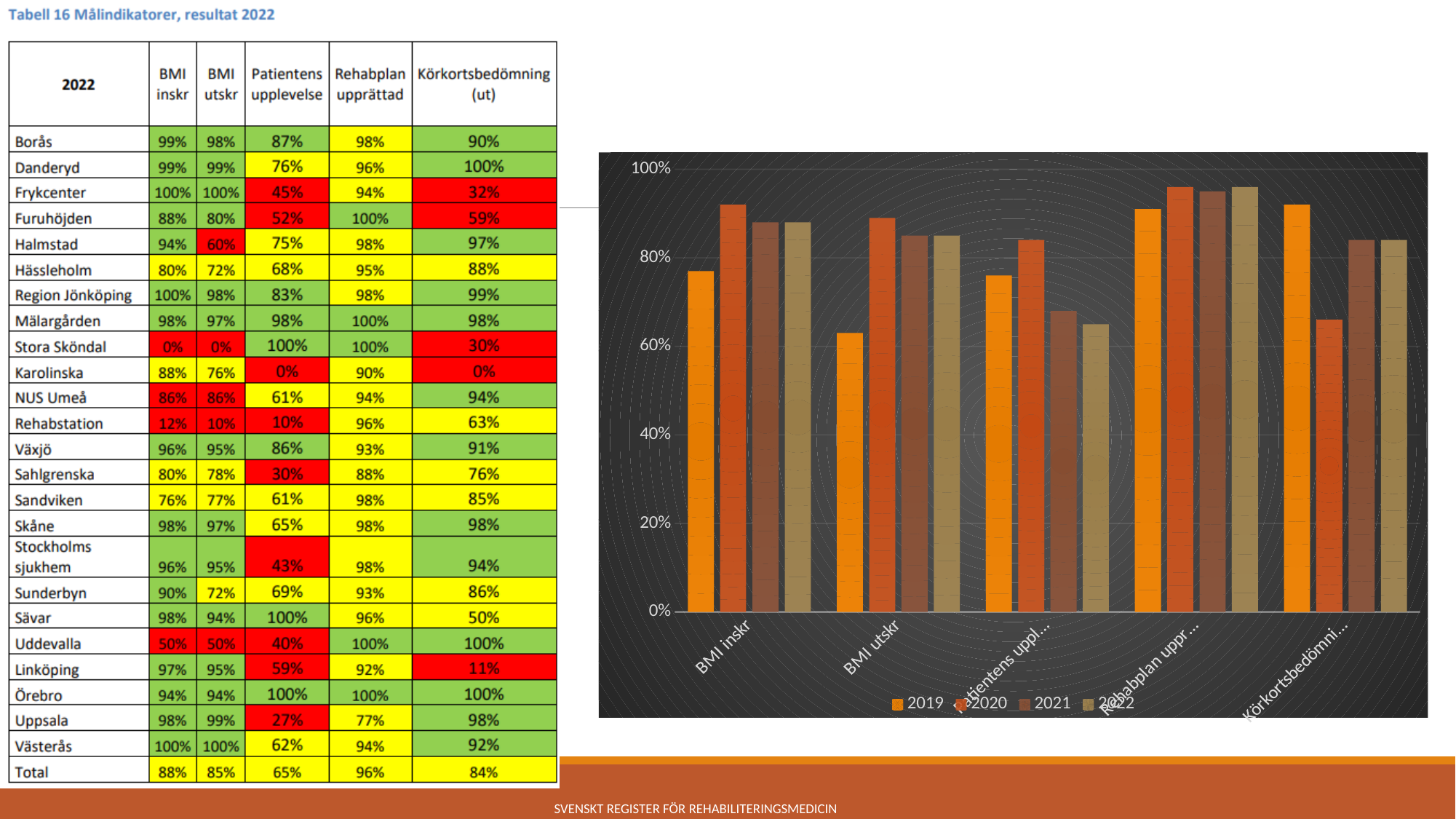
What kind of chart is shown on the right side of the slide? bar chart In the bar chart, is the 2021 value for Körkortsbedömning greater or less than 80%? greater In the bar chart, which year has the lowest value for BMI utskr? 2019 In the bar chart, which year has the highest value for BMI inskr? 2020 How many categories are shown along the x axis of the bar chart? 5 In the bar chart, which is larger for 2019: the value for BMI inskr or the value for BMI utskr? BMI inskr In the bar chart, is the 2019 value for BMI utskr greater or less than 80%? less In the bar chart, is the 2020 value for Rehabplan upprättad greater or less than 80%? greater Which years are listed in the legend of the bar chart? 2019, 2020, 2021, 2022 In the bar chart, which year has the lowest value for Körkortsbedömning? 2020 How many series does the legend of the bar chart list? 4